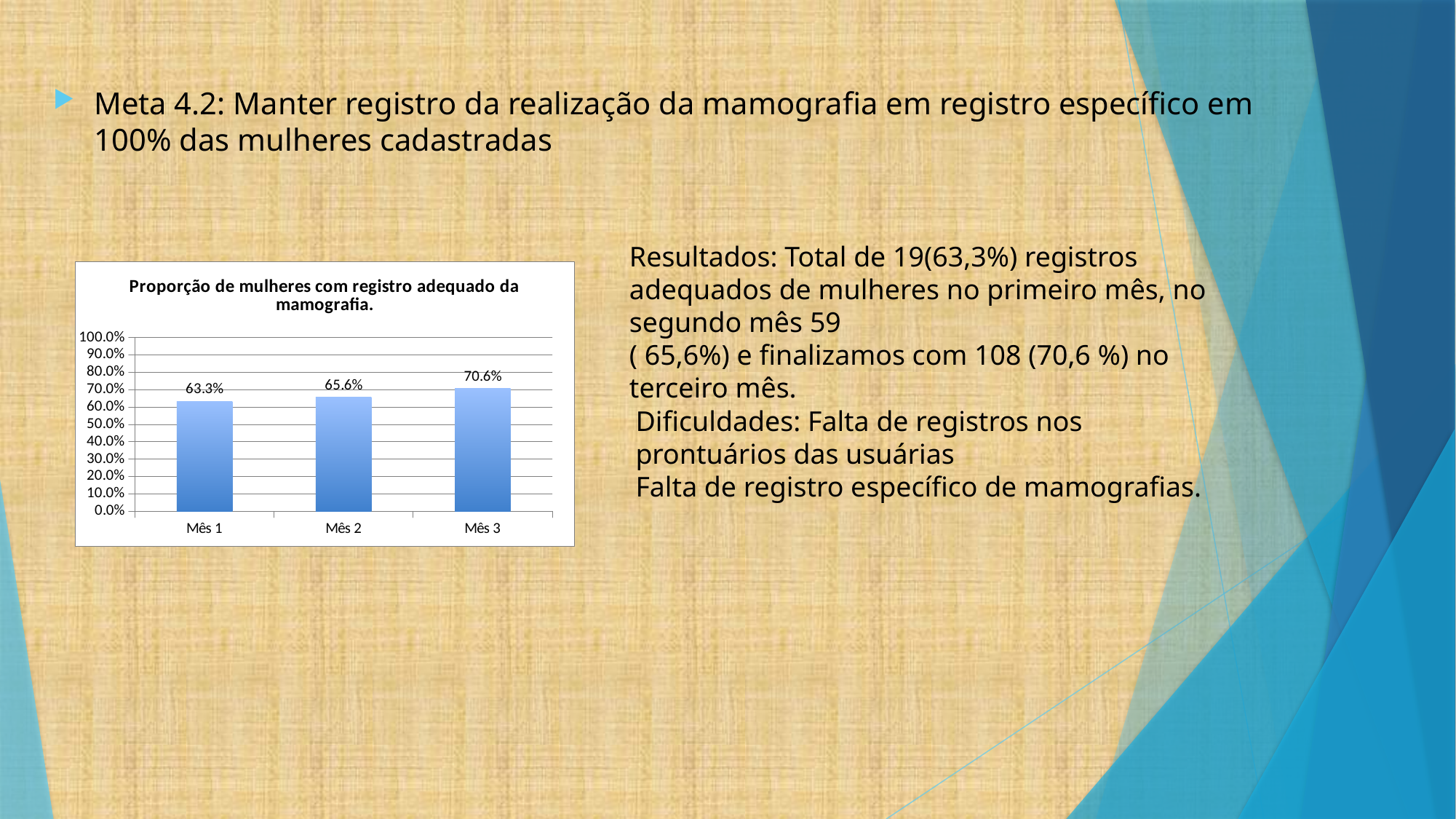
Is the value for Mês 3 greater or less than 60.0%? greater What is the value for Mês 2? 65.6% What is the difference between the values for Mês 3 and Mês 1? 7.3% What is the difference between the values for Mês 2 and Mês 1? 2.3% What is the value for Mês 3? 70.6% What kind of chart is shown on the slide? Bar chart Do the values rise or fall from Mês 1 to Mês 3? Rise How many months are shown on the x axis? 3 What is the value for Mês 1? 63.3% Which month has the highest value? Mês 3 Which month has the lowest value? Mês 1 Which is larger, the value for Mês 2 or the value for Mês 3? Mês 3